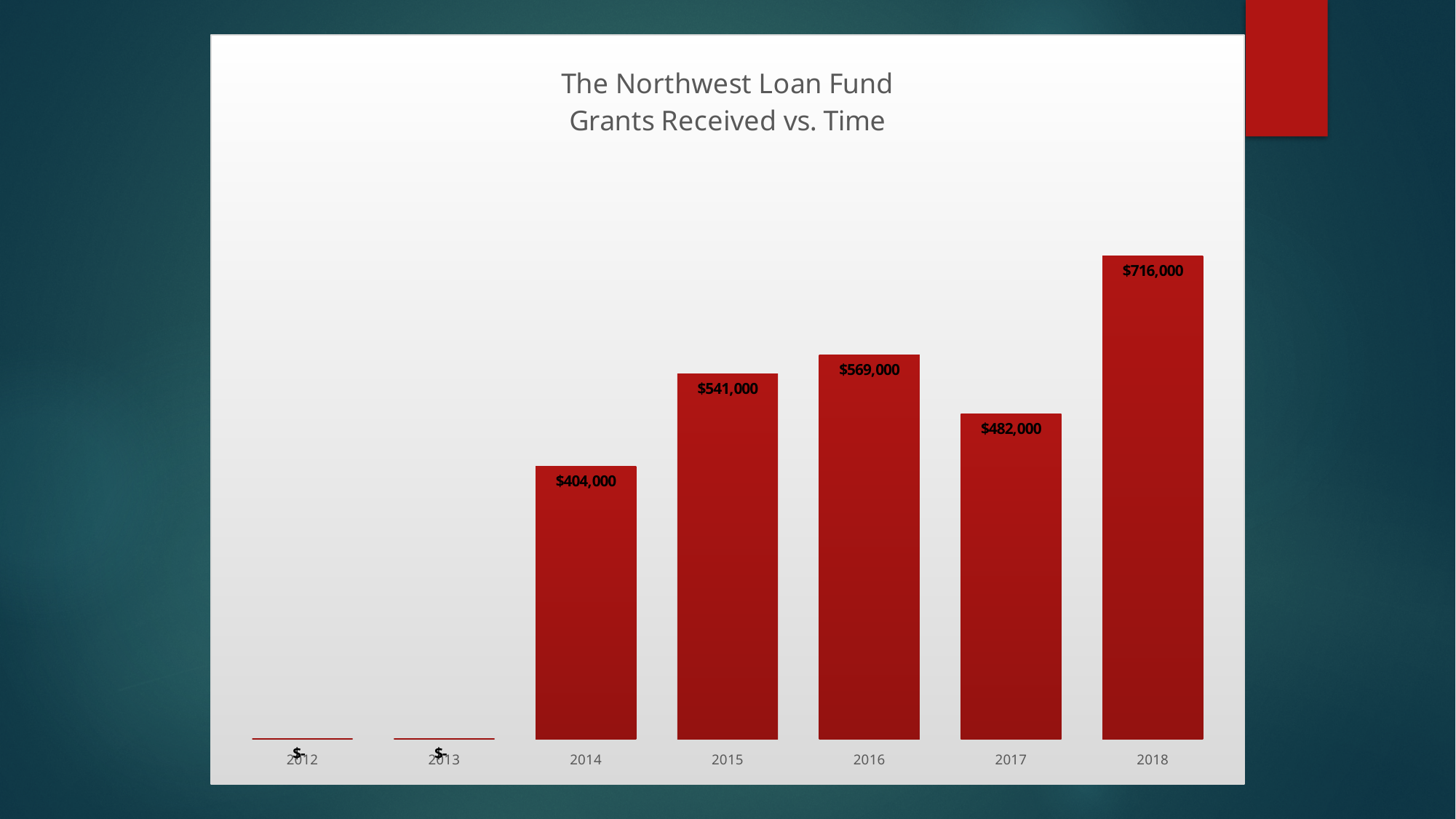
What is the value for 2014? $404,000 What is the difference between the values for 2016 and 2015? $28,000 What is the title of the chart? The Northwest Loan Fund Grants Received vs. Time What is the value for 2016? $569,000 How many years are shown on the x axis? 7 Which is larger, the value for 2015 or the value for 2017? 2015 What kind of chart is this? Bar chart Which year among 2014 to 2018 has the lowest grants received? 2014 What is the difference between the values for 2018 and 2017? $234,000 Which year has the highest grants received? 2018 What is the value for 2018? $716,000 What is the value for 2017? $482,000